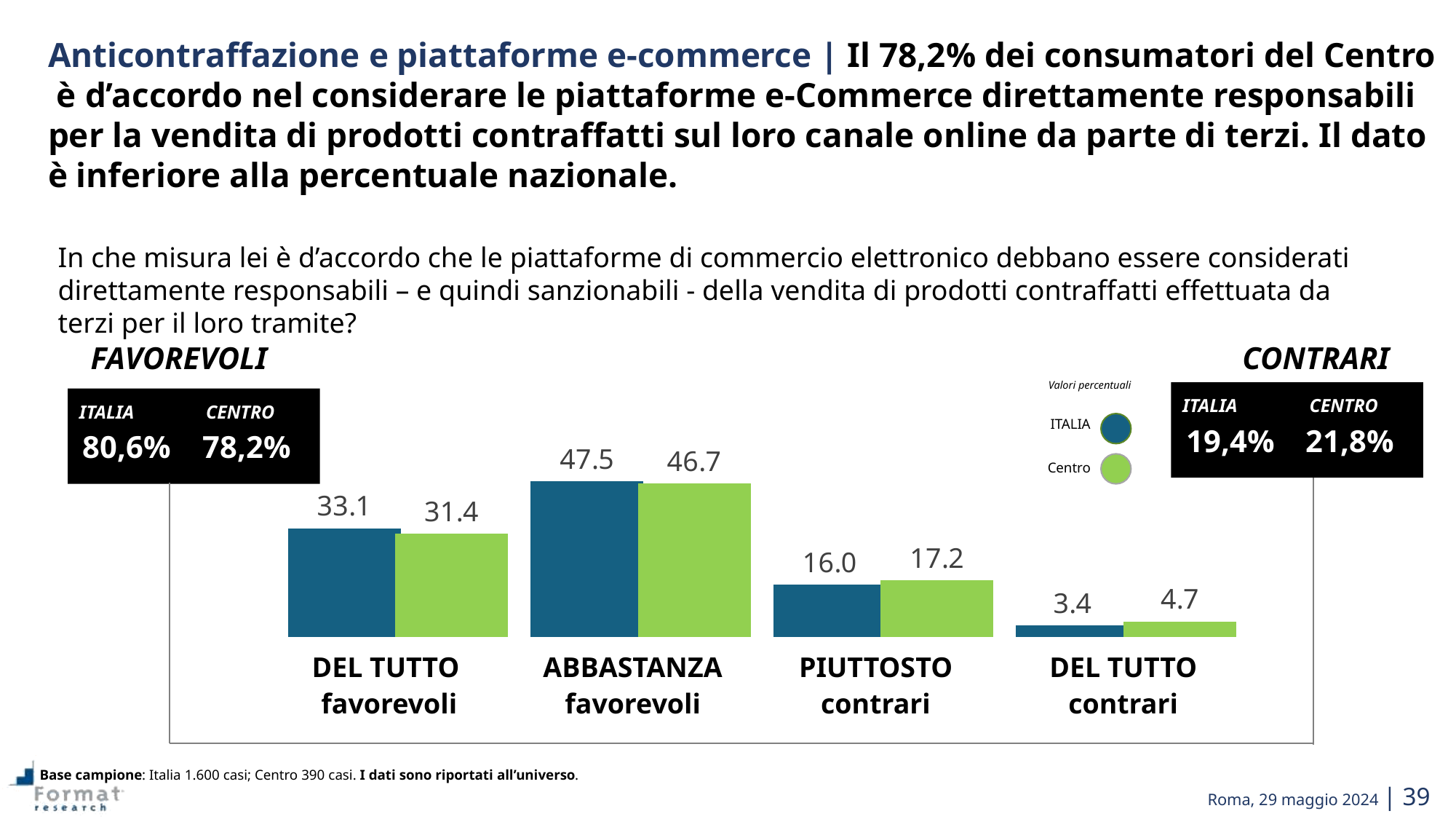
What kind of chart is shown on the slide? Bar chart What is the ITALIA value for DEL TUTTO favorevoli? 33.1 Which category has the highest ITALIA value? ABBASTANZA favorevoli What is the Centro value for ABBASTANZA favorevoli? 46.7 What is the difference between the ITALIA and Centro values for DEL TUTTO favorevoli? 1.7 What colour represents the Centro series in the chart? Green How many series does the legend list? 2 How many categories are shown on the x axis of the chart? 4 What is the Centro value for PIUTTOSTO contrari? 17.2 What is the ITALIA value for DEL TUTTO contrari? 3.4 Which category has the lowest Centro value? DEL TUTTO contrari For PIUTTOSTO contrari, which is larger: the ITALIA value or the Centro value? Centro